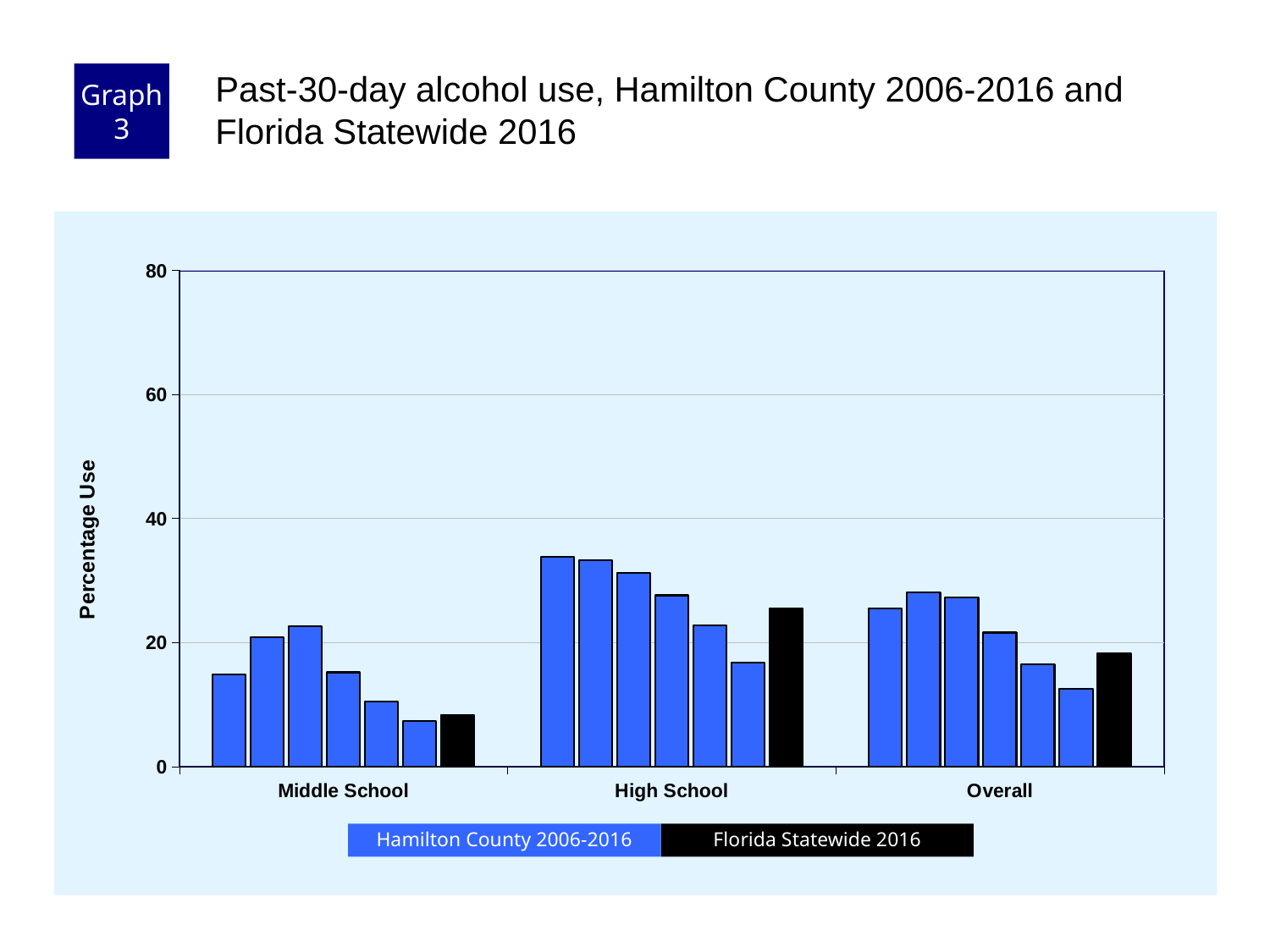
Is the tallest Hamilton County bar for High School greater or less than 40? less Which category has the highest Florida Statewide 2016 value? High School How many categories are shown on the x axis? 3 Is the Florida Statewide 2016 value for Overall greater or less than 20? less Do the Hamilton County 2006-2016 bars for High School rise or fall from left to right? fall Which category has the lowest Florida Statewide 2016 value? Middle School What kind of chart is shown on the slide? bar chart Which colour represents Florida Statewide 2016 in the chart? black Is the Florida Statewide 2016 value for Middle School greater or less than 20? less What is the label on the y axis? Percentage Use How many series does the legend list? 2